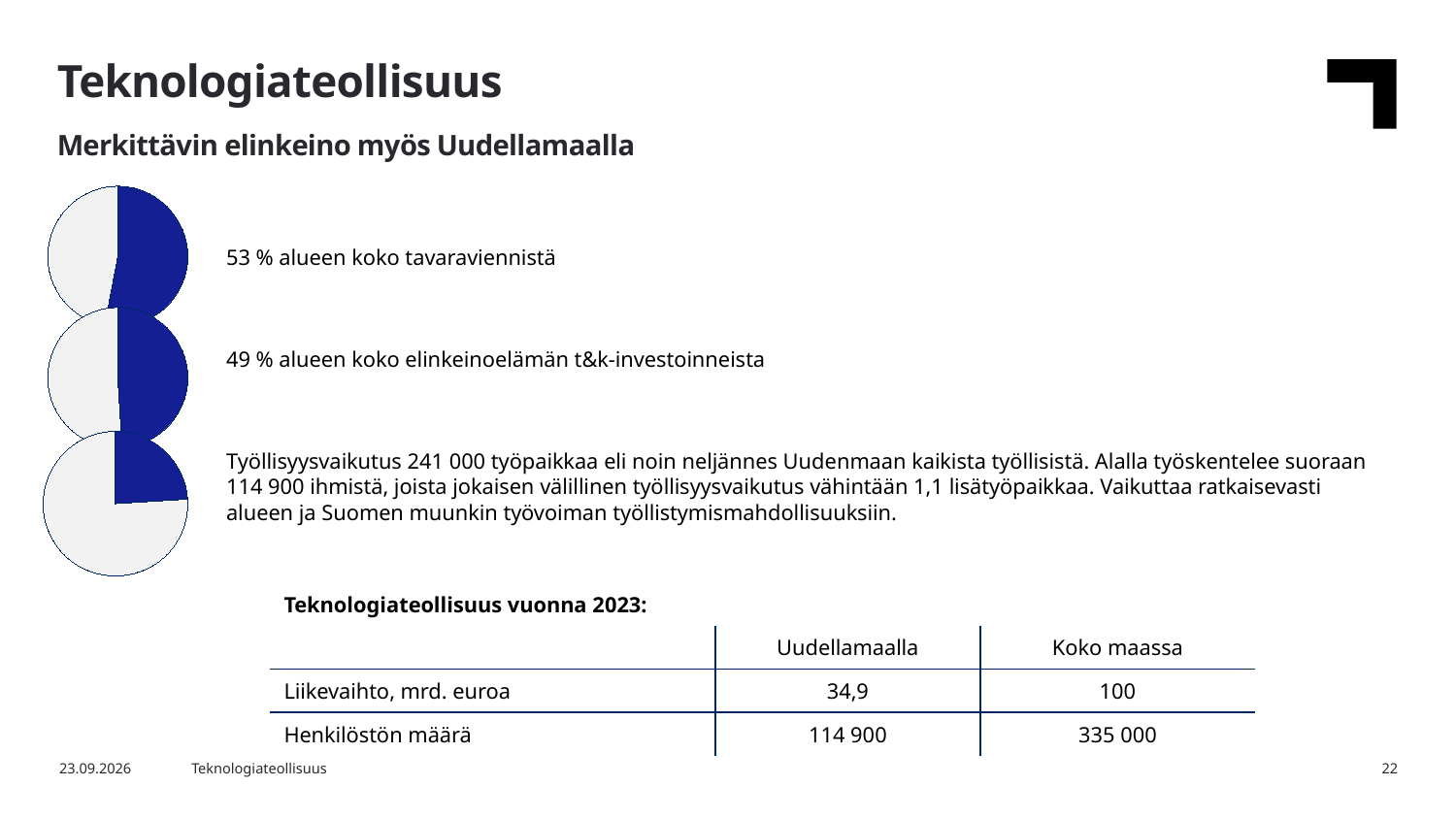
What is the difference between the blue shares of the top and middle pie charts? 4 percentage points What colour is used for the highlighted slice in the pie charts? Blue How many pie charts are on the slide? 3 Is the blue slice in the top pie chart greater or less than 50%? greater In the middle pie chart, what share of the region's business R&D investments does the blue slice represent? 49 % How many slices does each pie chart have? 2 What kind of charts are shown on the left side of the slide? Pie charts Is the blue slice in the bottom pie chart greater or less than 50%? less Which pie chart has the largest blue slice: the top, middle or bottom one? Top In the top pie chart, what share of the region's total goods exports does the blue slice represent? 53 % Which pie chart has the smallest blue slice: the top, middle or bottom one? Bottom Is the blue share in the top pie chart larger or smaller than the blue share in the middle pie chart? Larger